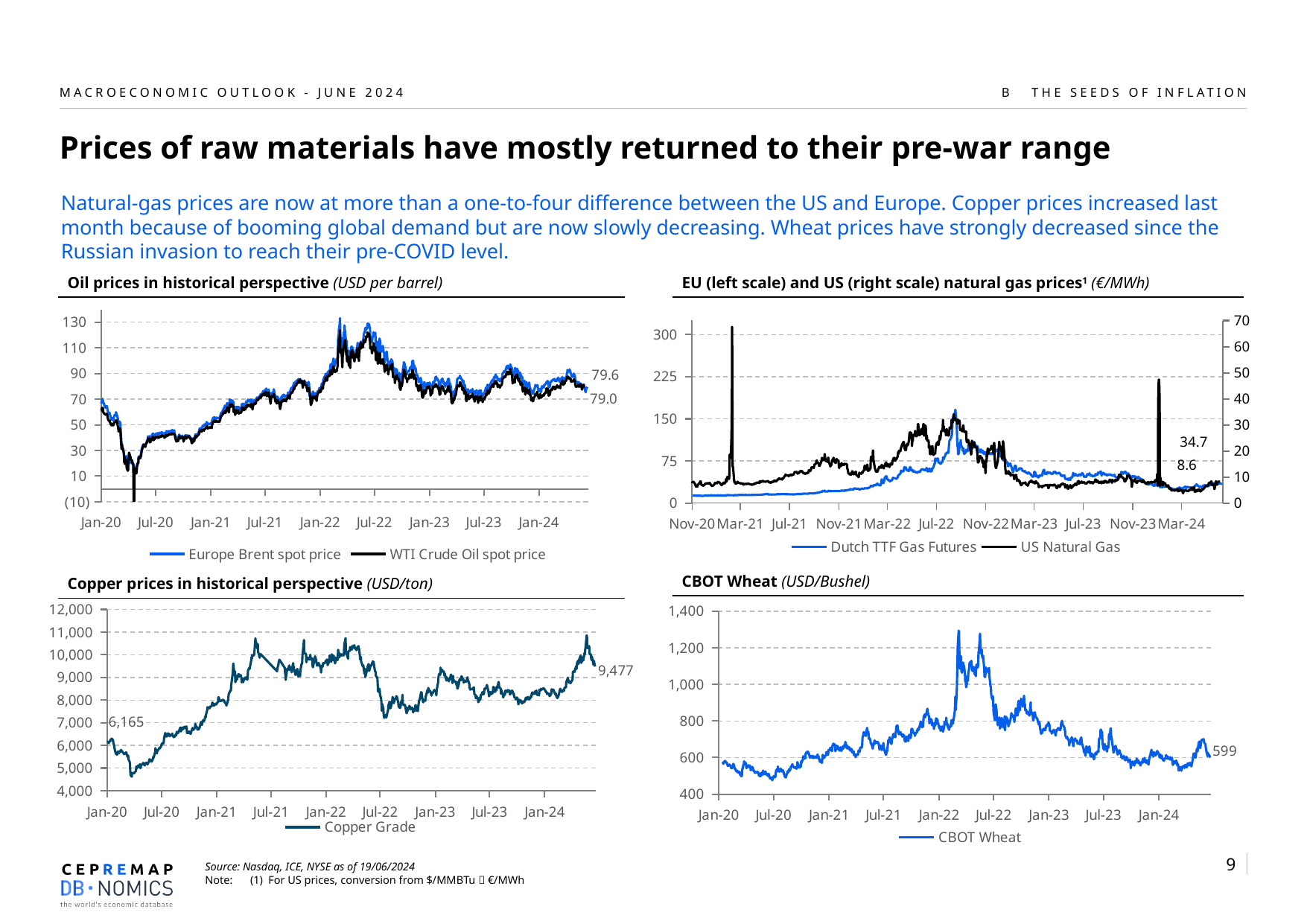
In the 'EU (left scale) and US (right scale) natural gas prices' chart, which series has the higher latest labelled value, Dutch TTF Gas Futures or US Natural Gas? Dutch TTF Gas Futures In the 'EU (left scale) and US (right scale) natural gas prices' chart, what is the latest labelled value for Dutch TTF Gas Futures? 34.7 In the 'Oil prices in historical perspective' chart, what is the latest labelled value for the WTI Crude Oil spot price? 79.0 In the 'Copper prices in historical perspective' chart, what is the difference between the latest labelled value and the starting labelled value? 3,312 In the 'Oil prices in historical perspective' chart, what is the difference between the latest labelled Brent value and the latest labelled WTI value? 0.6 What kind of chart is the 'CBOT Wheat' chart? Line chart In the 'EU (left scale) and US (right scale) natural gas prices' chart, what is the latest labelled value for US Natural Gas? 8.6 In the 'CBOT Wheat' chart, what is the latest labelled value? 599 In the 'Copper prices in historical perspective' chart, what is the latest labelled value for Copper Grade? 9,477 In the 'Copper prices in historical perspective' chart, what is the labelled value at the start of the series? 6,165 How many series does the legend of the 'Oil prices in historical perspective' chart list? 2 In the 'Oil prices in historical perspective' chart, what is the latest labelled value for the Europe Brent spot price? 79.6